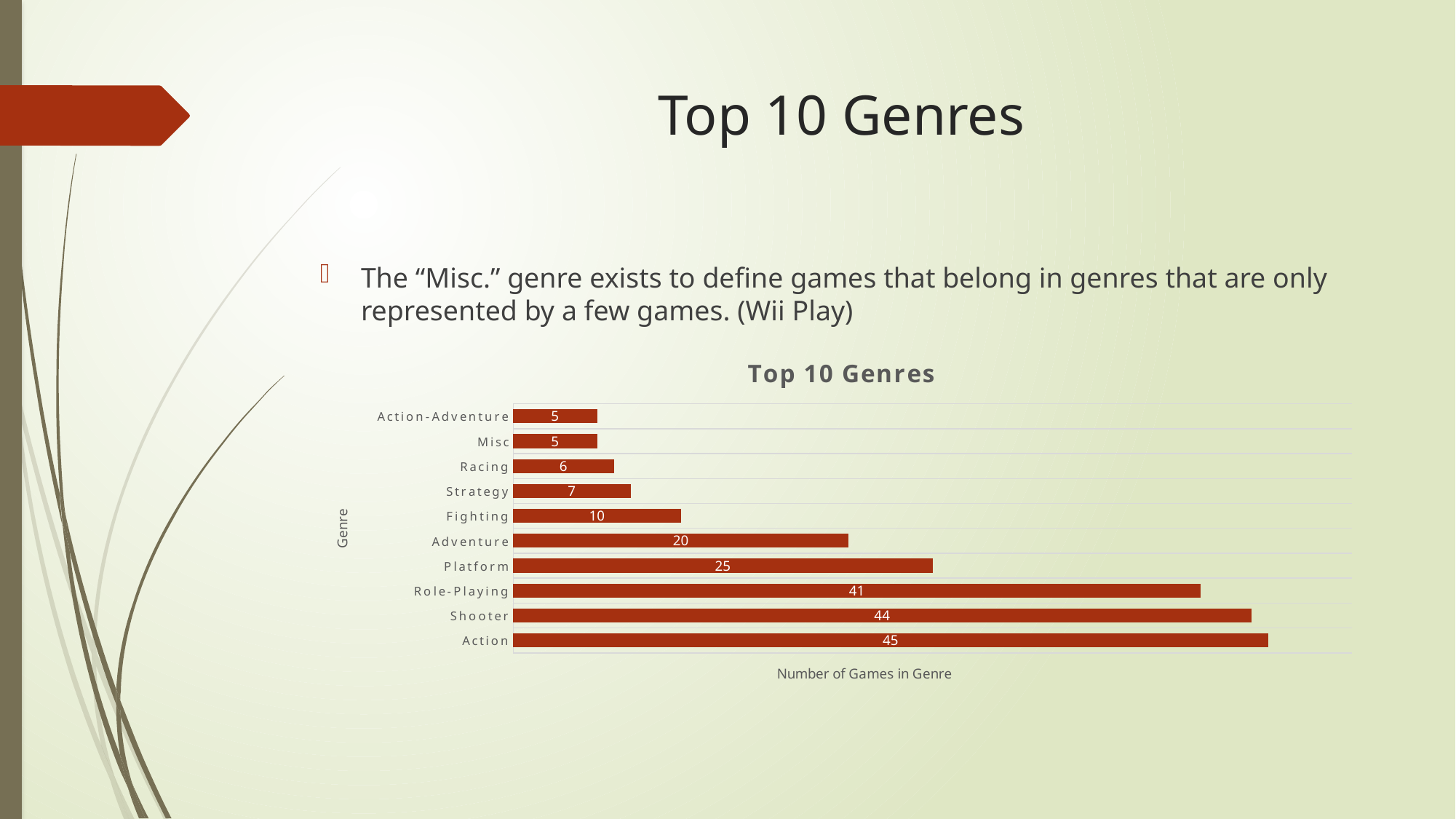
What is the number of games in the Action genre? 45 Which genre has the highest number of games? Action What is the difference between the number of Shooter games and Platform games? 19 How many genres are shown in the chart? 10 What is the number of games in the Fighting genre? 10 Which has more games, Racing or Fighting? Fighting What is the number of games in the Role-Playing genre? 41 What kind of chart is shown on the slide? Bar chart What is the title of the chart? Top 10 Genres Which has more games, Role-Playing or Platform? Role-Playing What is the difference between the number of Adventure games and Strategy games? 13 What is the label of the horizontal axis of the chart? Number of Games in Genre